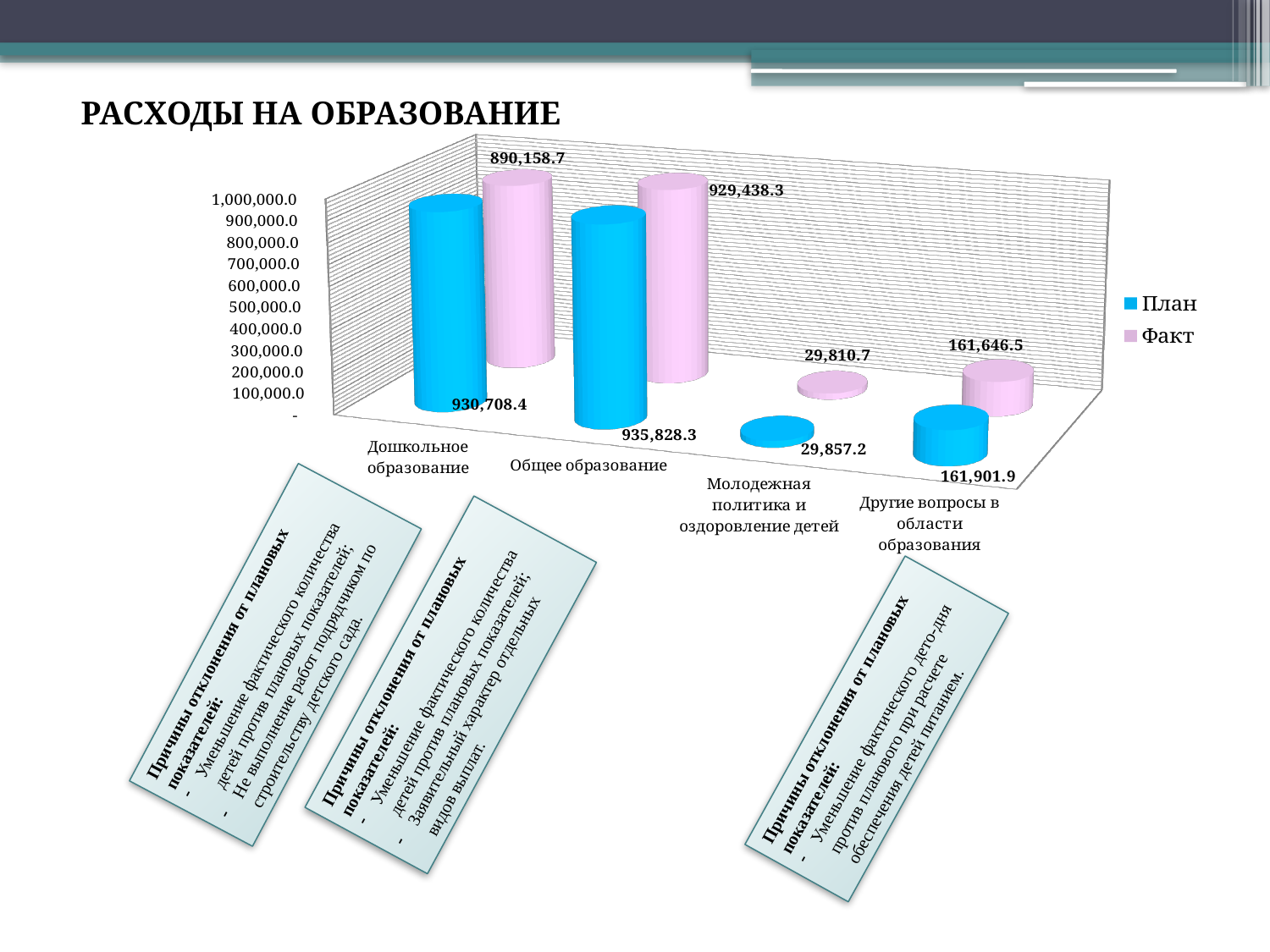
Which category has the highest Факт value? Общее образование What is the difference between the План and Факт values for Дошкольное образование? 40,549.7 What is the План value for Дошкольное образование? 930,708.4 Which is larger for Дошкольное образование, the План value or the Факт value? План What is the difference between the План and Факт values for Общее образование? 6,390.0 What is the План value for Молодежная политика и оздоровление детей? 29,857.2 How many series does the legend list? 2 What is the Факт value for Общее образование? 929,438.3 Which category has the lowest План value? Молодежная политика и оздоровление детей What is the Факт value for Другие вопросы в области образования? 161,646.5 How many categories are shown on the x axis? 4 What is the title of the chart? РАСХОДЫ НА ОБРАЗОВАНИЕ